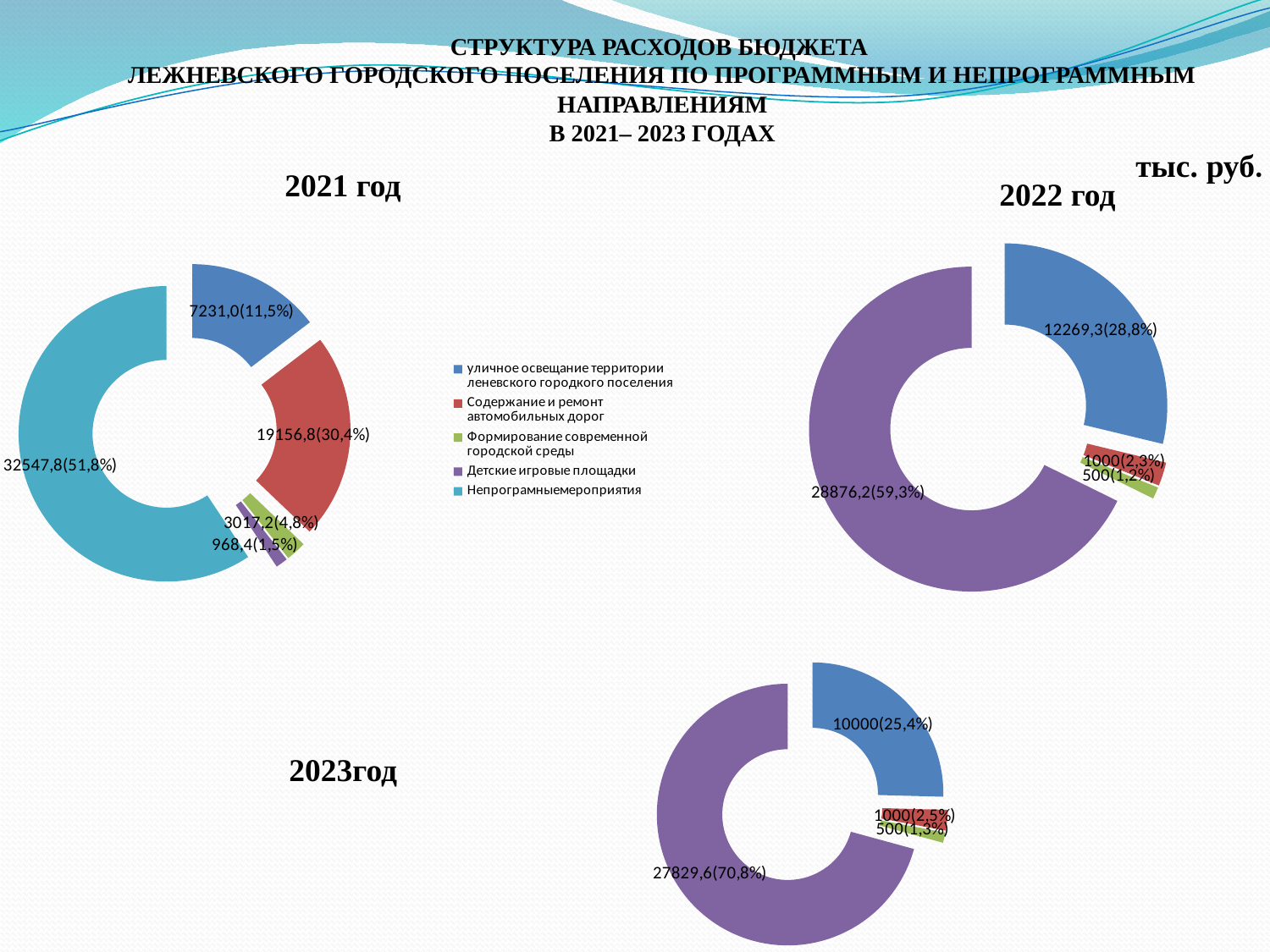
How many series does the legend list? 5 In the 2023 год chart, what share of the total does уличное освещение территории have? 25,4% In the 2021 год chart, what share of the total does уличное освещение территории have? 11,5% In the 2022 год chart, what value is shown for уличное освещение территории? 12269,3(28,8%) In the 2023 год chart, what value is shown for Детские игровые площадки? 27829,6(70,8%) In the 2021 год chart, what value is shown for Непрограмные мероприятия? 32547,8(51,8%) In the 2021 год chart, what value is shown for Содержание и ремонт автомобильных дорог? 19156,8(30,4%) In the 2021 год chart, which category has the largest slice? Непрограмные мероприятия What kind of chart is used for the 2022 год data? Doughnut chart In the 2022 год chart, which category has the smallest slice? Формирование современной городской среды In the 2023 год chart, which is larger: Содержание и ремонт автомобильных дорог or Формирование современной городской среды? Содержание и ремонт автомобильных дорог In the 2022 год chart, what value is shown for Детские игровые площадки? 28876,2(59,3%)